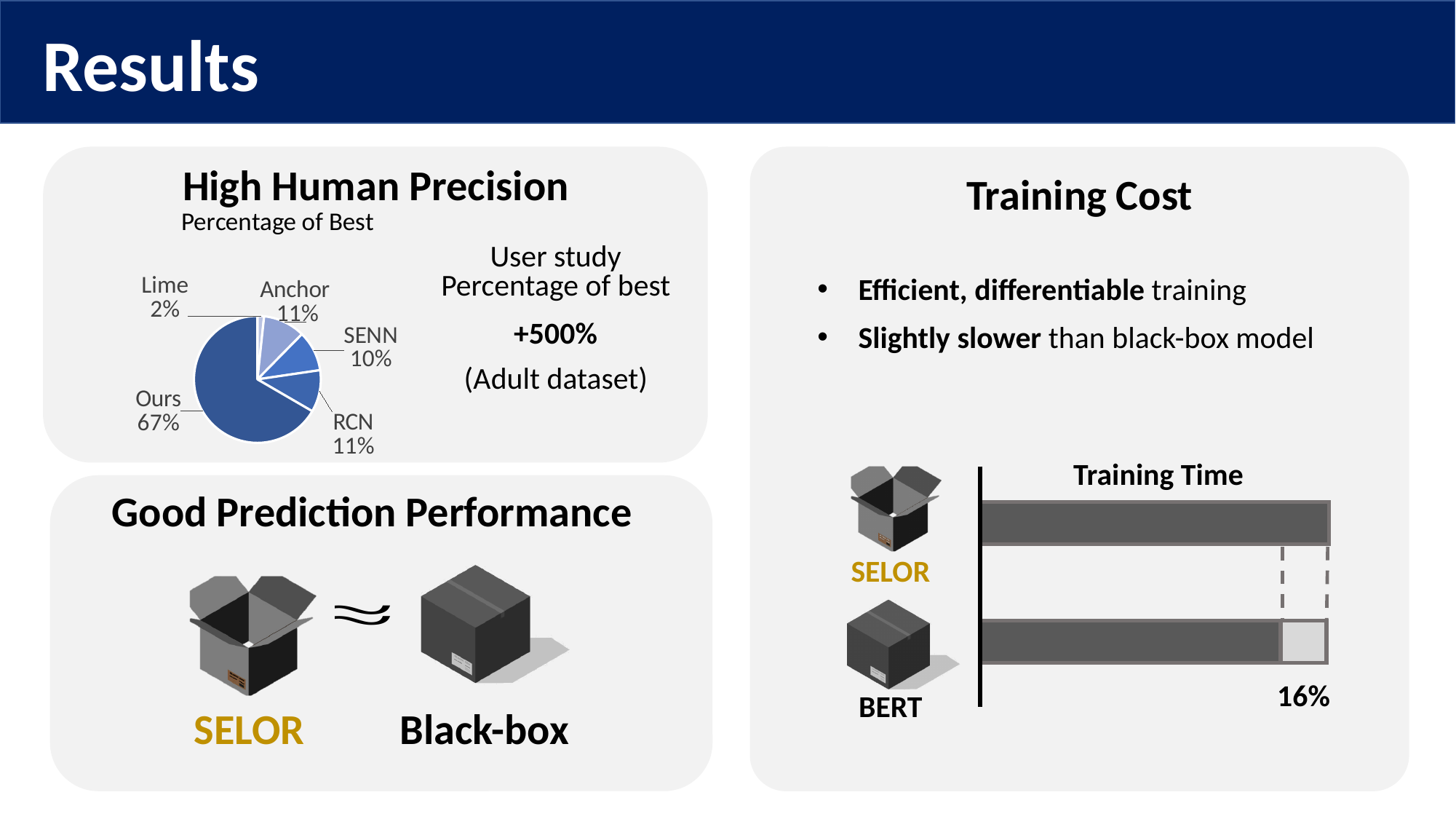
In the Percentage of Best pie chart, which method has the largest slice? Ours In the Percentage of Best pie chart, what share does Anchor have? 11% In the Percentage of Best pie chart, what share does Ours have? 67% In the Training Time chart, which model has the longer bar, SELOR or BERT? SELOR In the Percentage of Best pie chart, what share does SENN have? 10% In the Percentage of Best pie chart, how many percentage points larger is Ours than Anchor? 56 How many slices does the Percentage of Best pie chart have? 5 In the Percentage of Best pie chart, what share does Lime have? 2% In the Percentage of Best pie chart, which method has the smallest slice? Lime In the Percentage of Best pie chart, which is larger, SENN or Anchor? Anchor In the Percentage of Best pie chart, what share does RCN have? 11% What type of chart is used under the High Human Precision heading? Pie chart